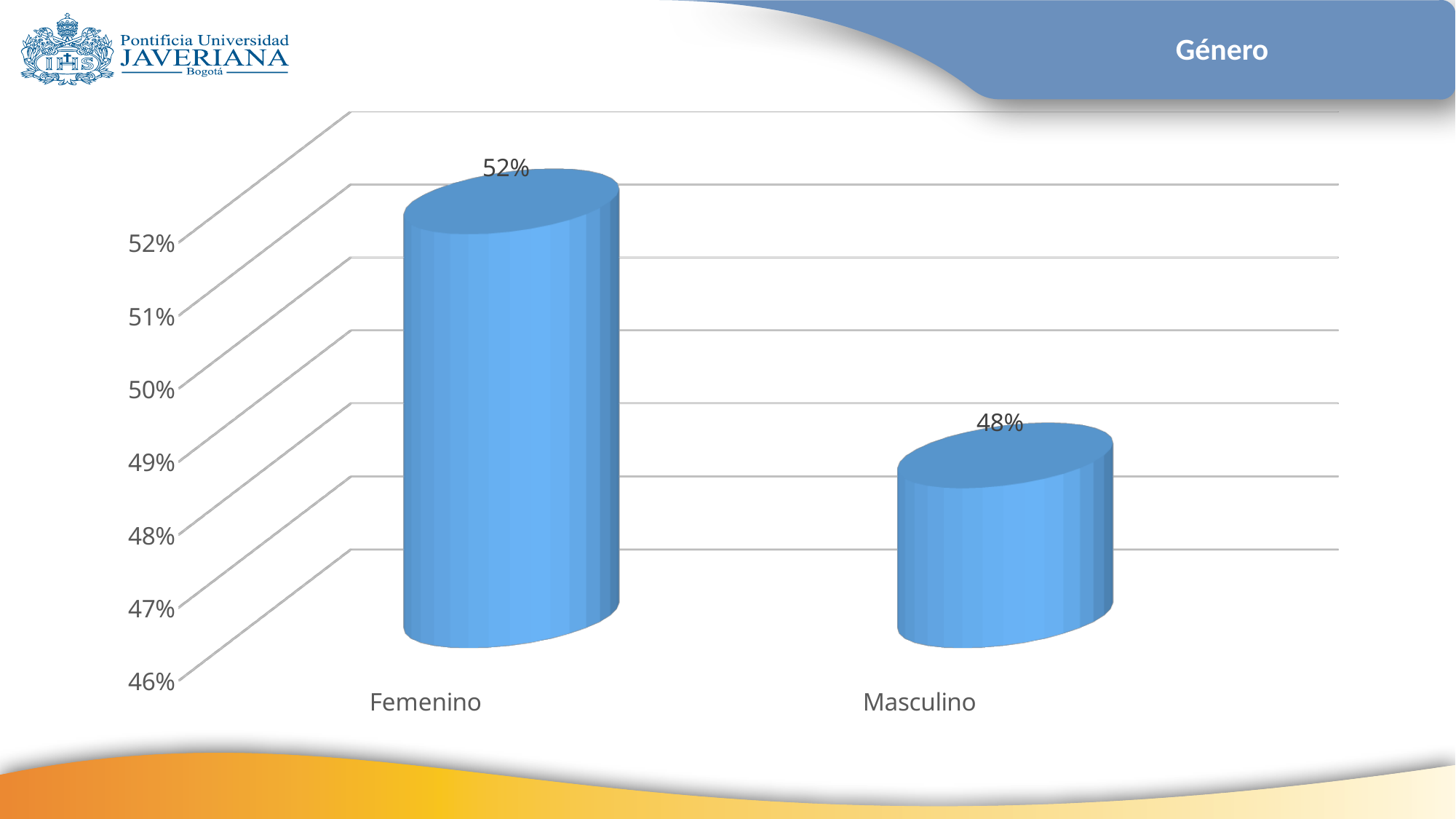
What is the title shown in the slide header above the chart? Género Which category has the highest value? Femenino What kind of chart is shown on the slide? bar chart What is the difference between the values for Femenino and Masculino? 4% What is the value for Masculino? 48% How many categories are shown on the chart? 2 What is the lowest value shown on the vertical axis? 46% Which category has the lowest value? Masculino What is the value for Femenino? 52% Is the value for Femenino greater or less than 50%? greater Is the value for Masculino greater or less than 50%? less Which is larger, the value for Femenino or the value for Masculino? Femenino